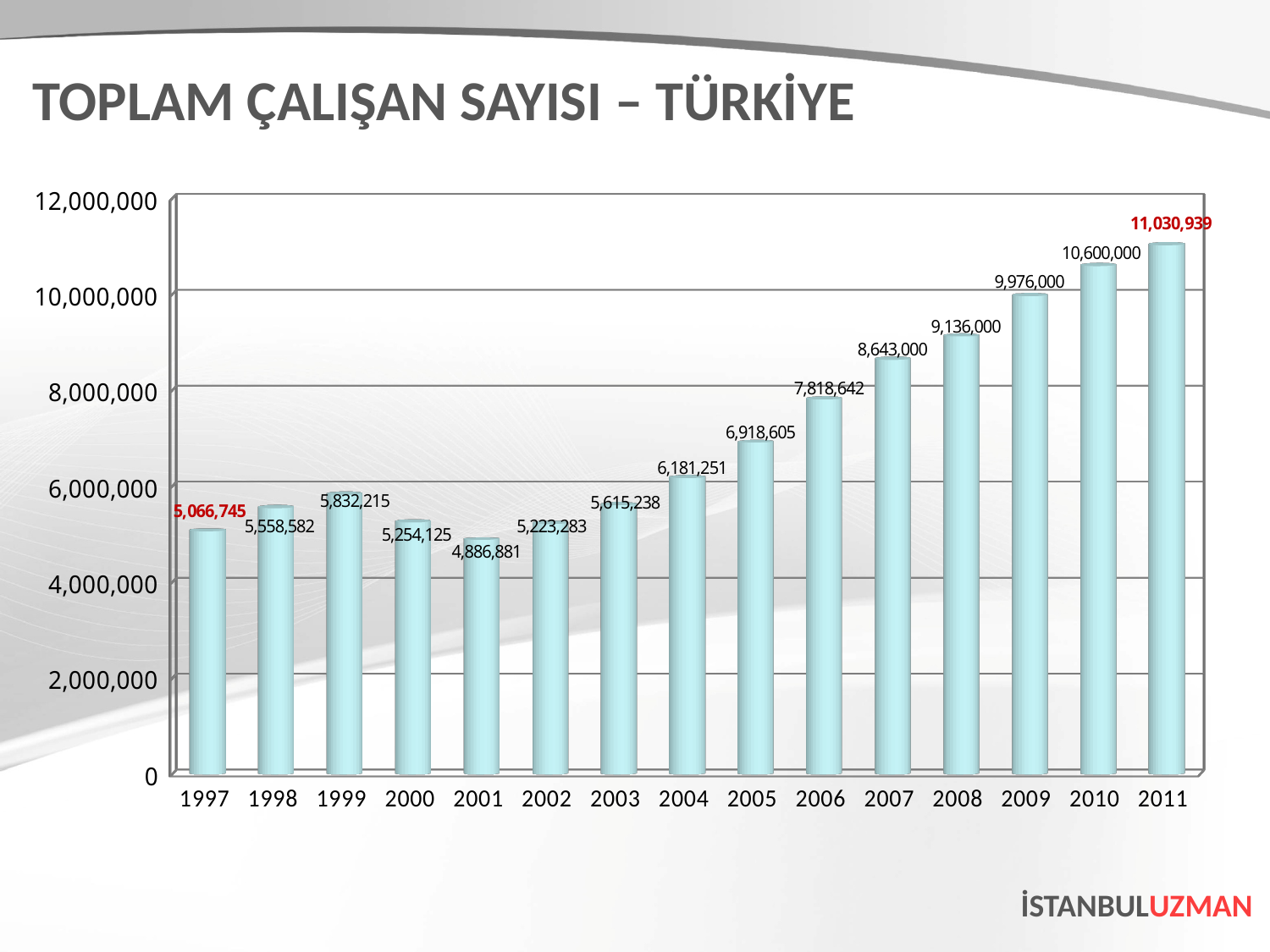
What is the difference between the values for 2010 and 2009? 624,000 What is the value for 2011? 11,030,939 Which year has the lowest value? 2001 How many years are shown on the x axis? 15 What kind of chart is shown on the slide? bar chart What is the value for 1997? 5,066,745 Is the value for 2006 greater or less than 8,000,000? less Which year has the highest value? 2011 What is the title of the chart? TOPLAM ÇALIŞAN SAYISI – TÜRKİYE What is the difference between the values for 2011 and 1997? 5,964,194 What is the value for 2005? 6,918,605 Which is larger, the value for 1999 or the value for 2003? 1999